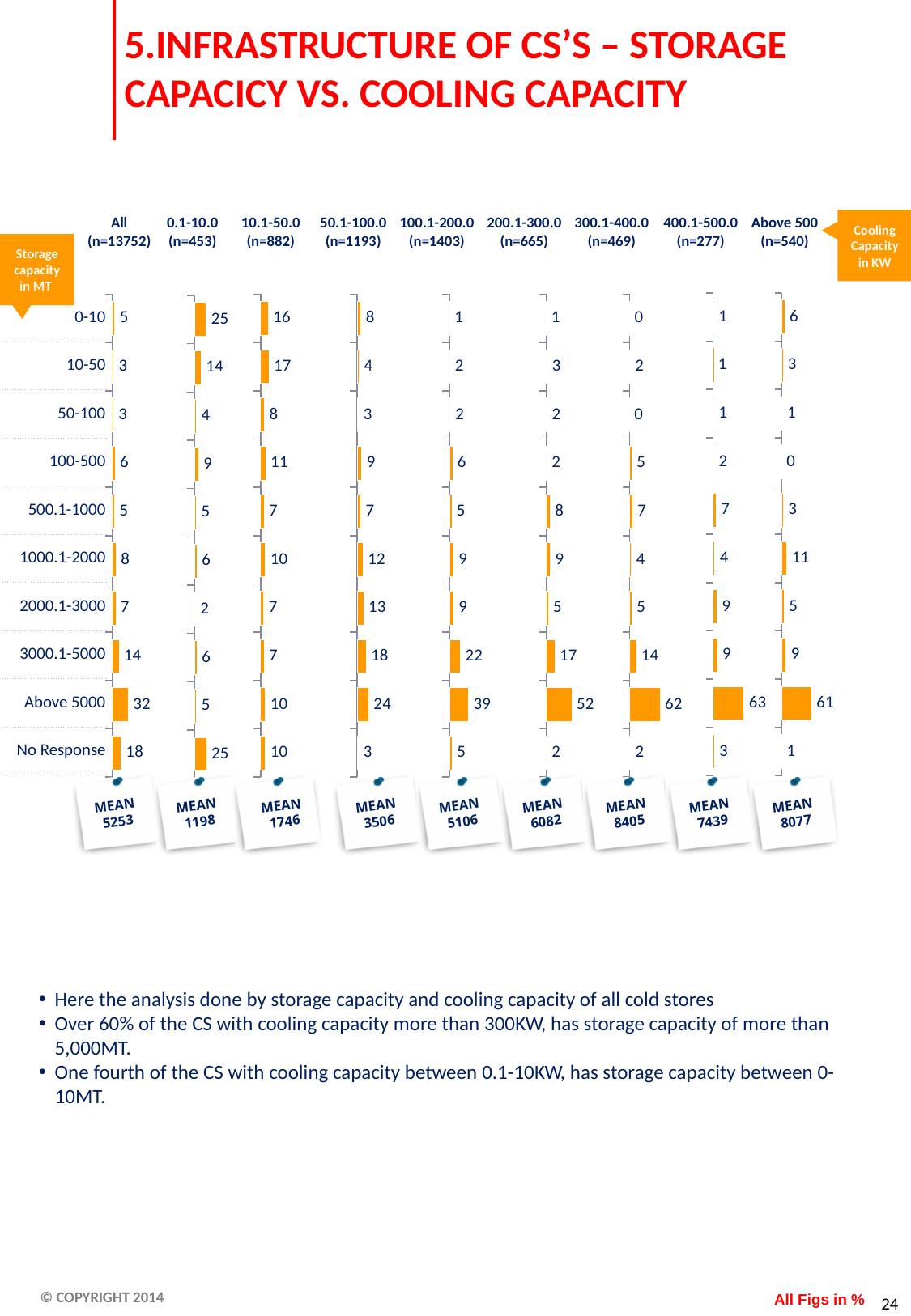
In the '0.1-10.0 (n=453)' chart, what is the value for 'No Response'? 25 In the '300.1-400.0 (n=469)' chart, which storage capacity category has the highest value? Above 5000 In the '200.1-300.0 (n=665)' chart, which storage capacity category has the lowest value? 0-10 In the '200.1-300.0 (n=665)' chart, which is larger: the value for '3000.1-5000' or the value for '500.1-1000'? 3000.1-5000 What kind of chart is used in each cooling capacity column? Bar chart In the 'All (n=13752)' chart, what is the value for the 'Above 5000' storage capacity category? 32 In the '0.1-10.0 (n=453)' chart, which is larger: the value for '0-10' or the value for '10-50'? 0-10 What is the MEAN shown below the '400.1-500.0 (n=277)' chart? 7439 In the 'All (n=13752)' chart, what is the difference between the 'Above 5000' value and the 'No Response' value? 14 How many storage capacity categories are listed down the left side of the charts? 10 In the '100.1-200.0 (n=1403)' chart, what is the value for the '3000.1-5000' category? 22 In the 'Above 500 (n=540)' chart, what is the value for the '1000.1-2000' category? 11